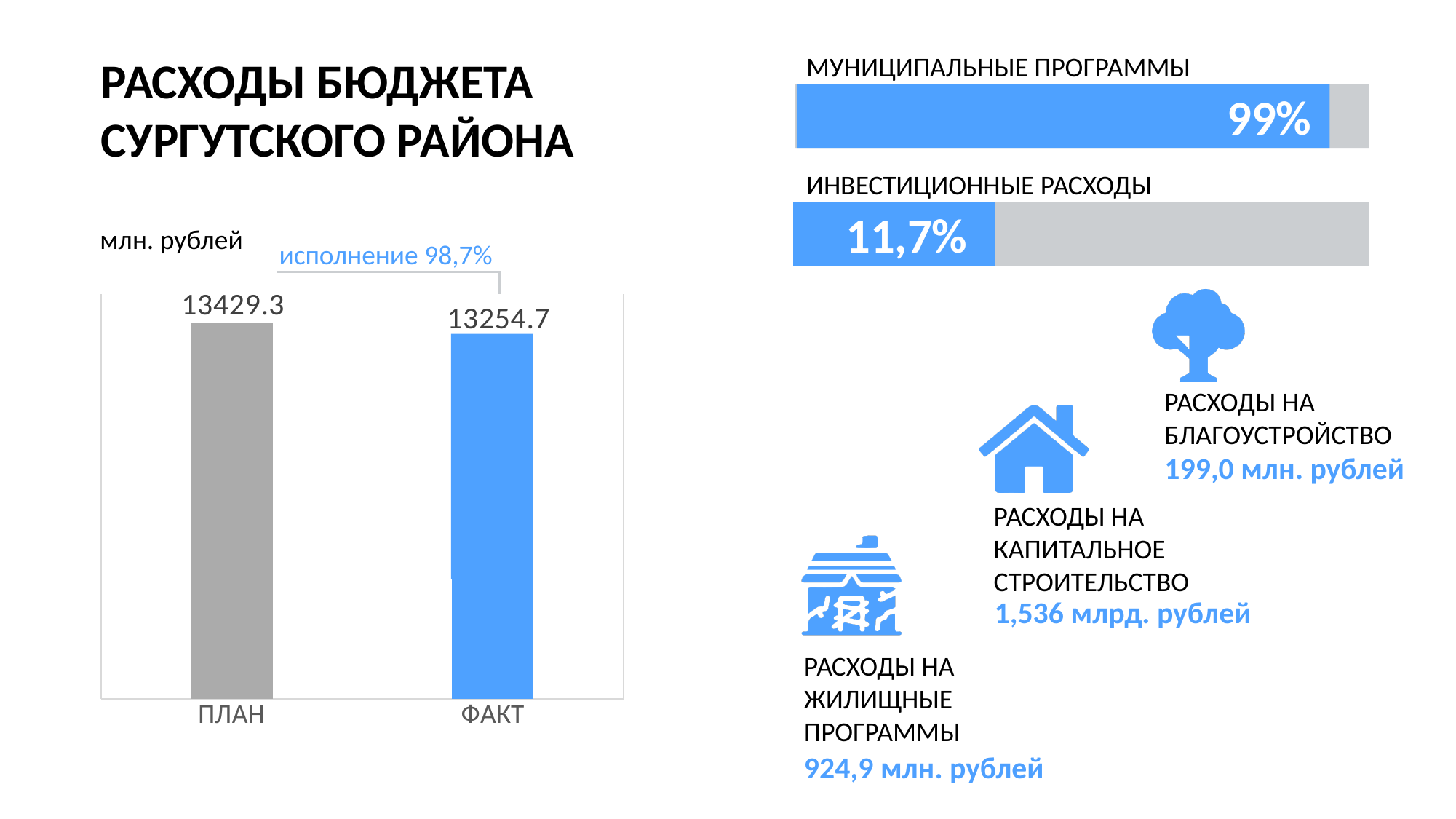
What type of chart is shown on the left of the slide? bar chart What colour is the ФАКТ bar in the bar chart? blue What is the value of the ФАКТ bar in the bar chart? 13254.7 Which bar in the bar chart is higher, ПЛАН or ФАКТ? ПЛАН What is the value of the ПЛАН bar in the bar chart? 13429.3 What is the difference between the ПЛАН and ФАКТ values in the bar chart? 174.6 Which category has the highest value in the bar chart? ПЛАН How many bars are shown in the bar chart? 2 Do the values in the bar chart rise or fall from ПЛАН to ФАКТ? fall What execution percentage (исполнение) is annotated above the bar chart? 98,7% Which category has the lowest value in the bar chart? ФАКТ What unit is indicated for the values in the bar chart? млн. рублей